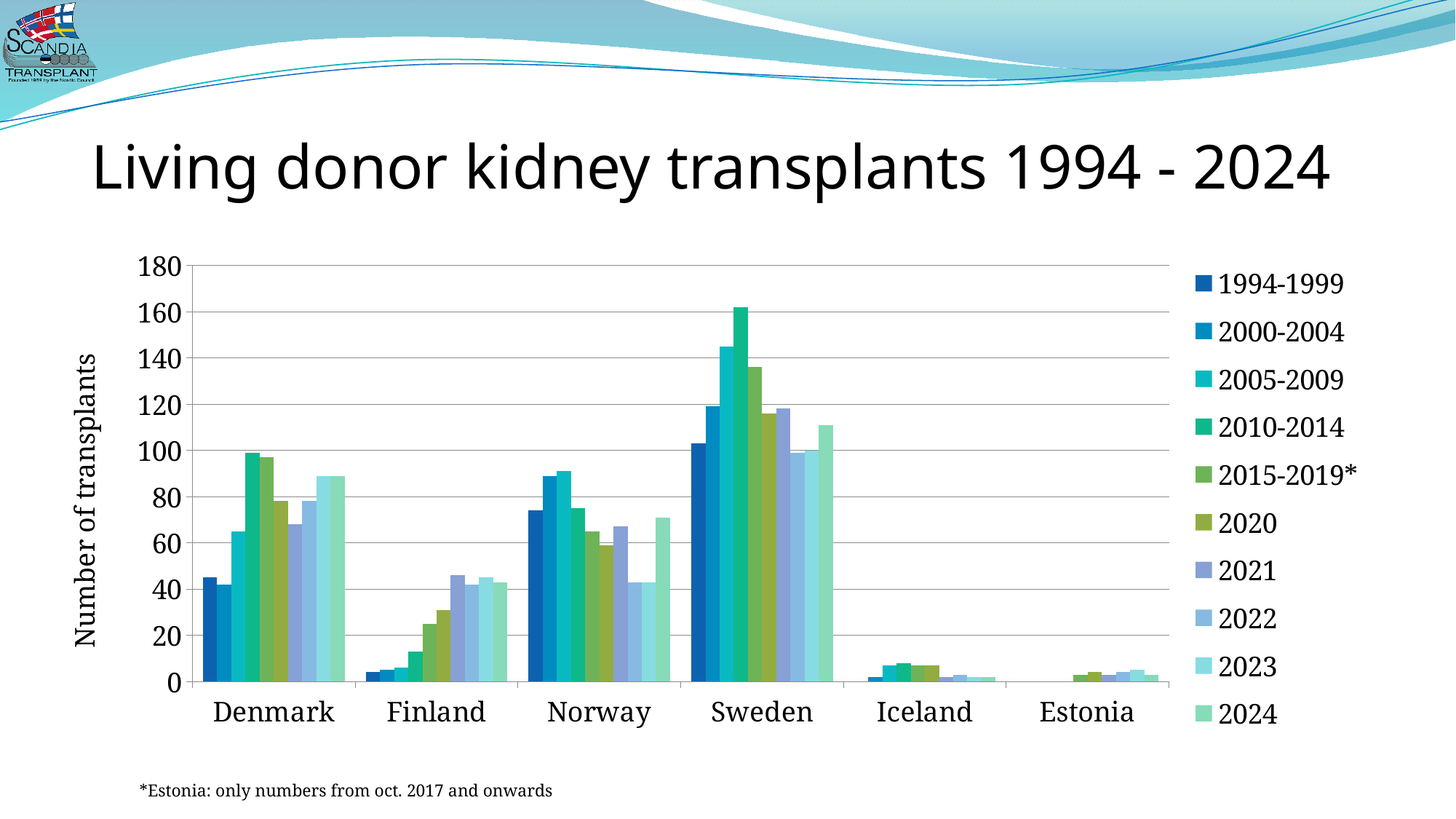
How many series does the legend list? 10 What kind of chart is shown on the slide? Bar chart What is the label of the y axis? Number of transplants Which is larger, the 2020 value for Denmark or the 2020 value for Norway? Denmark Is the value for Denmark in 2024 greater or less than 80? greater Is the value for Sweden in 2010-2014 greater or less than 140? greater How many countries are shown on the x axis of the chart? 6 For Sweden, which period has the highest number of transplants? 2010-2014 Is the value for Finland in 1994-1999 greater or less than 20? less Which is larger, the 2024 value for Norway or the 2024 value for Finland? Norway Which country has the tallest bar in the chart? Sweden